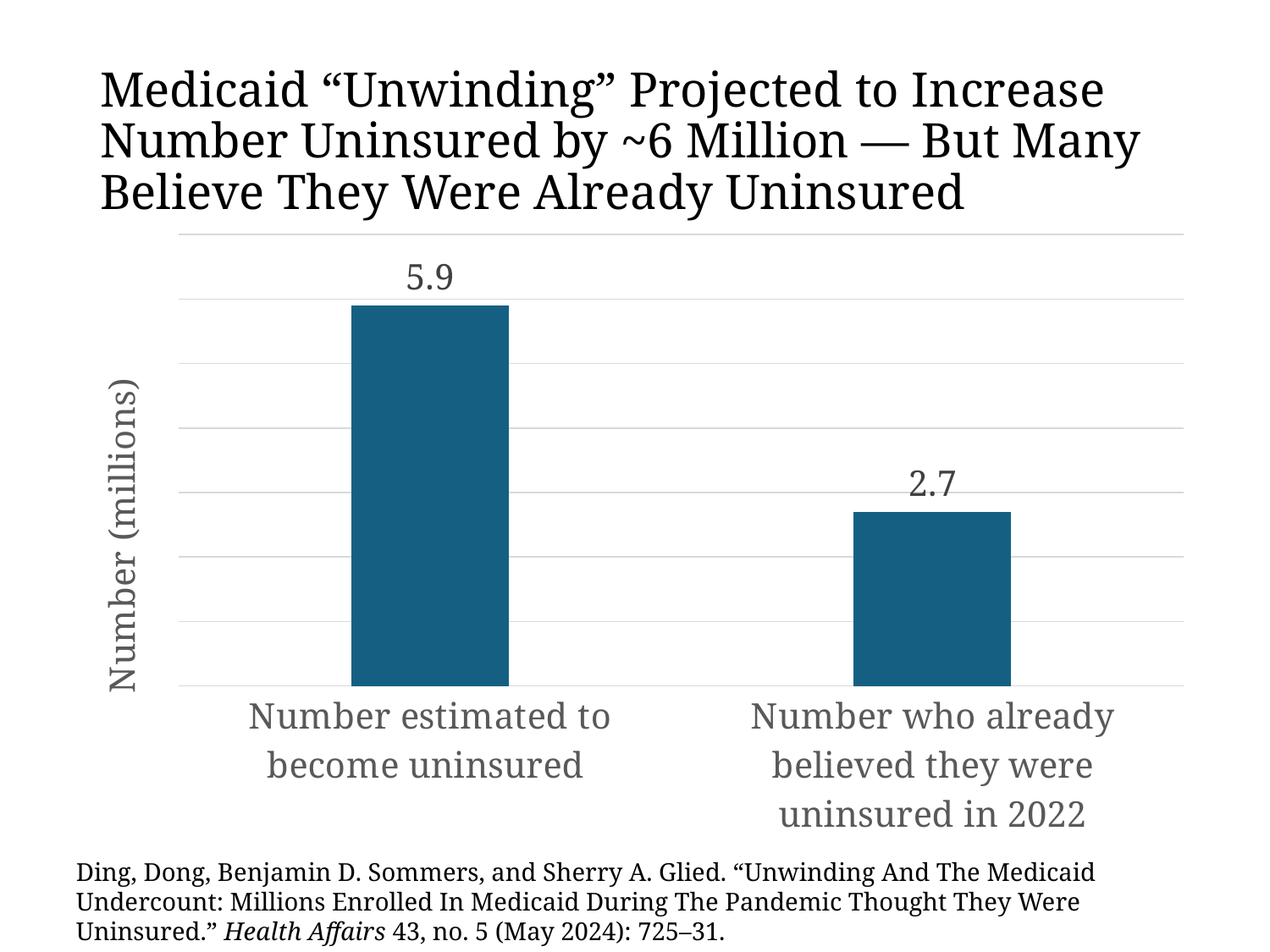
What is the label of the vertical axis? Number (millions) How many categories are shown in the chart? 2 What is the value for "Number who already believed they were uninsured in 2022"? 2.7 What is the difference between the value for "Number estimated to become uninsured" and the value for "Number who already believed they were uninsured in 2022"? 3.2 Which is larger: the value for "Number estimated to become uninsured" or the value for "Number who already believed they were uninsured in 2022"? Number estimated to become uninsured What is the value for "Number estimated to become uninsured"? 5.9 What kind of chart is shown on the slide? Bar chart Which category has the highest value? Number estimated to become uninsured What colour are the bars in the chart? Blue Which category has the lowest value? Number who already believed they were uninsured in 2022